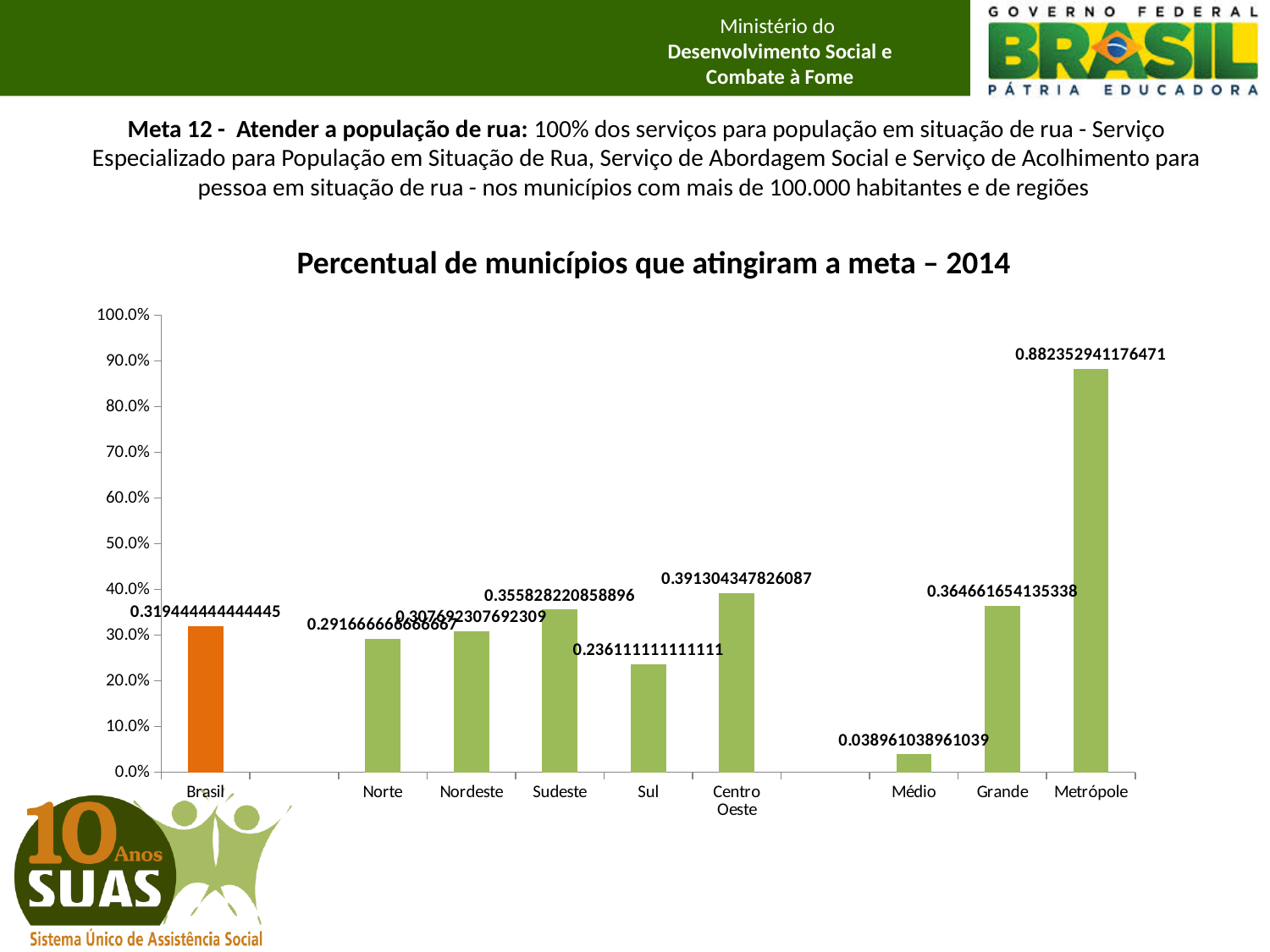
What is the value shown for Sul? 0.236111111111111 How many bars are plotted in the chart? 9 What is the value shown for Brasil? 0.319444444444445 What kind of chart is shown on the slide? Bar chart What is the title of the chart? Percentual de municípios que atingiram a meta – 2014 Which category has the highest bar? Metrópole What is the value shown for Metrópole? 0.882352941176471 Which category has the lowest bar? Médio Which is larger, the value for Centro Oeste or the value for Sudeste? Centro Oeste What is the value shown for Médio? 0.038961038961039 Is the value for Sul greater or less than 30.0%? less What is the difference between the values for Centro Oeste and Sul? 0.155193236714976